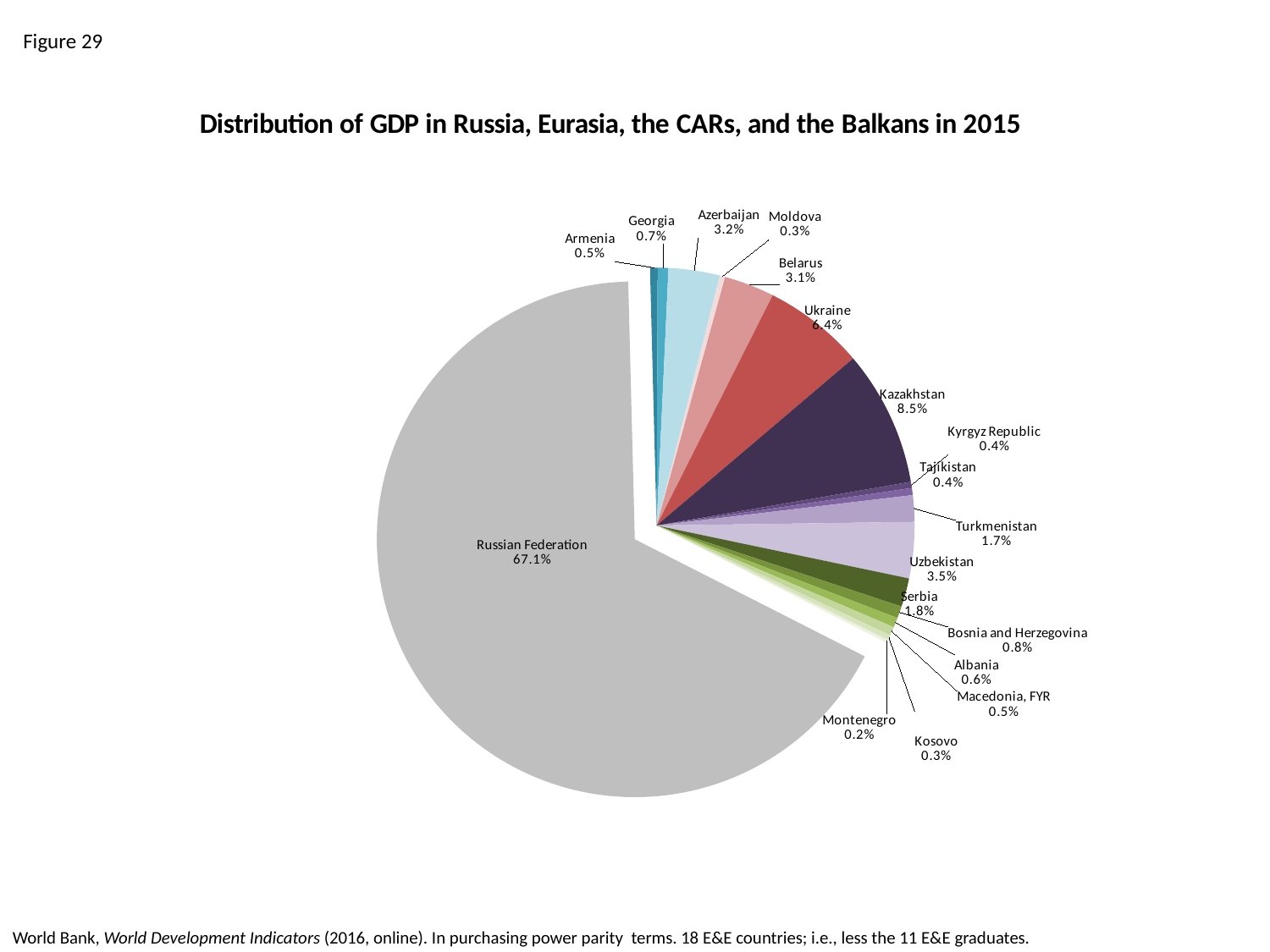
Which country has the largest share of GDP in the chart? Russian Federation How many countries are shown as slices in the pie chart? 18 What is the title of the chart? Distribution of GDP in Russia, Eurasia, the CARs, and the Balkans in 2015 What is the difference between the shares of Kazakhstan and Ukraine? 2.1% What is the value shown for Uzbekistan? 3.5% What is the value shown for Ukraine? 6.4% What share of GDP does the Russian Federation account for? 67.1% Which has a larger share of GDP, Azerbaijan or Belarus? Azerbaijan Which country has the smallest share of GDP in the chart? Montenegro What is the combined share of Serbia and Bosnia and Herzegovina? 2.6% What is the value shown for Kazakhstan? 8.5% What type of chart is shown on the slide? pie chart